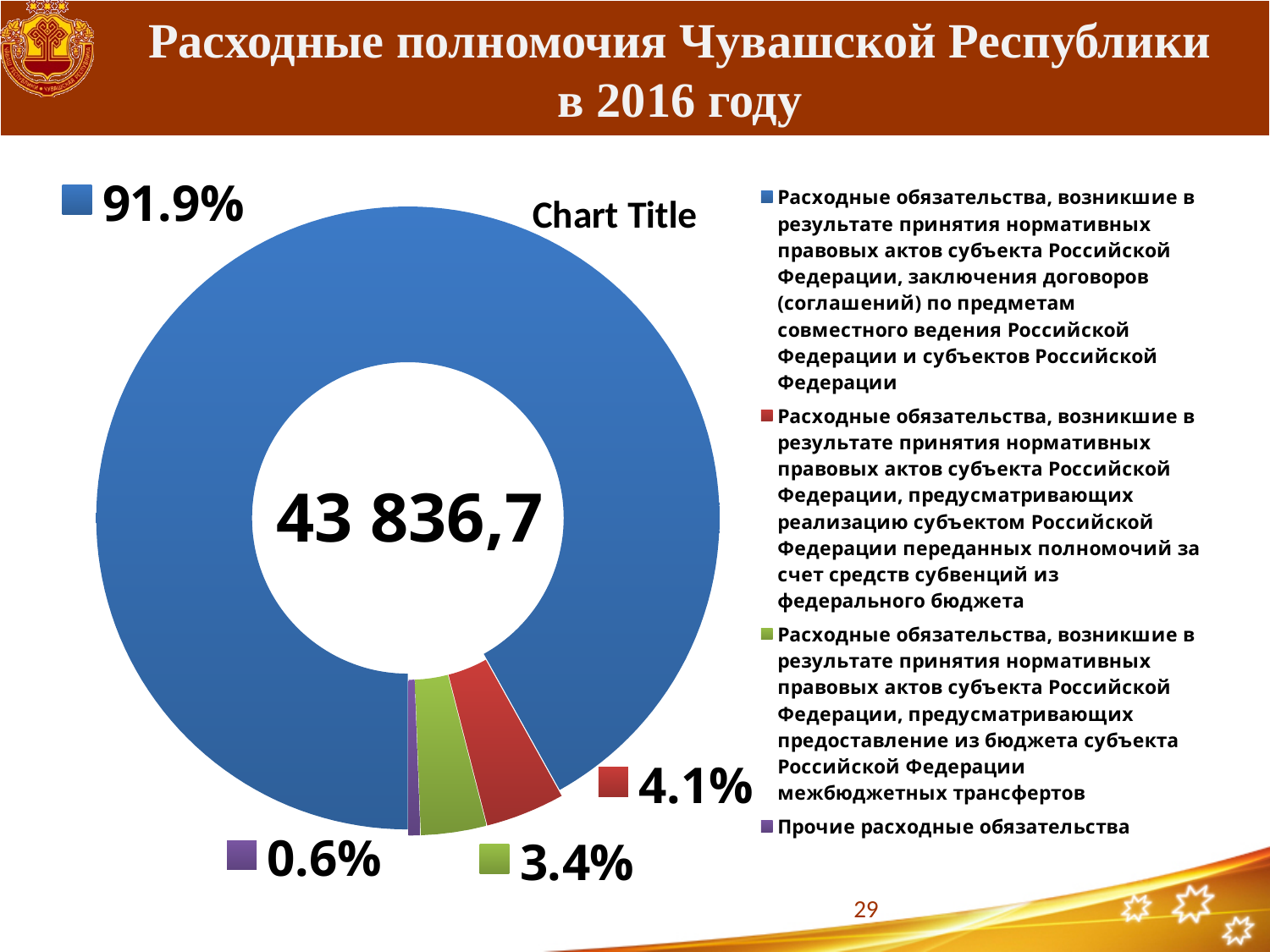
How many categories (slices) does the chart contain? 4 Which category has the smallest share of the chart? Прочие расходные обязательства (0.6%) What share of the chart does the slice for "Прочие расходные обязательства" represent? 0.6% What type of chart is shown on the slide? doughnut (pie) chart What percentage is shown for the green slice (obligations for providing interbudgetary transfers from the regional budget)? 3.4% Which is larger: the share for delegated powers funded by federal subventions or the share for interbudgetary transfers? delegated powers funded by federal subventions (4.1%) What percentage is shown for the blue slice (expenditure obligations on subjects of joint jurisdiction of the Russian Federation and its subjects)? 91.9% What number is displayed in the centre of the doughnut chart? 43 836,7 What percentage is shown for the red slice (obligations for delegated powers funded by subventions from the federal budget)? 4.1% What is the title shown on the chart itself? Chart Title What is the difference in percentage points between the red slice (4.1%) and the green slice (3.4%)? 0.7 percentage points